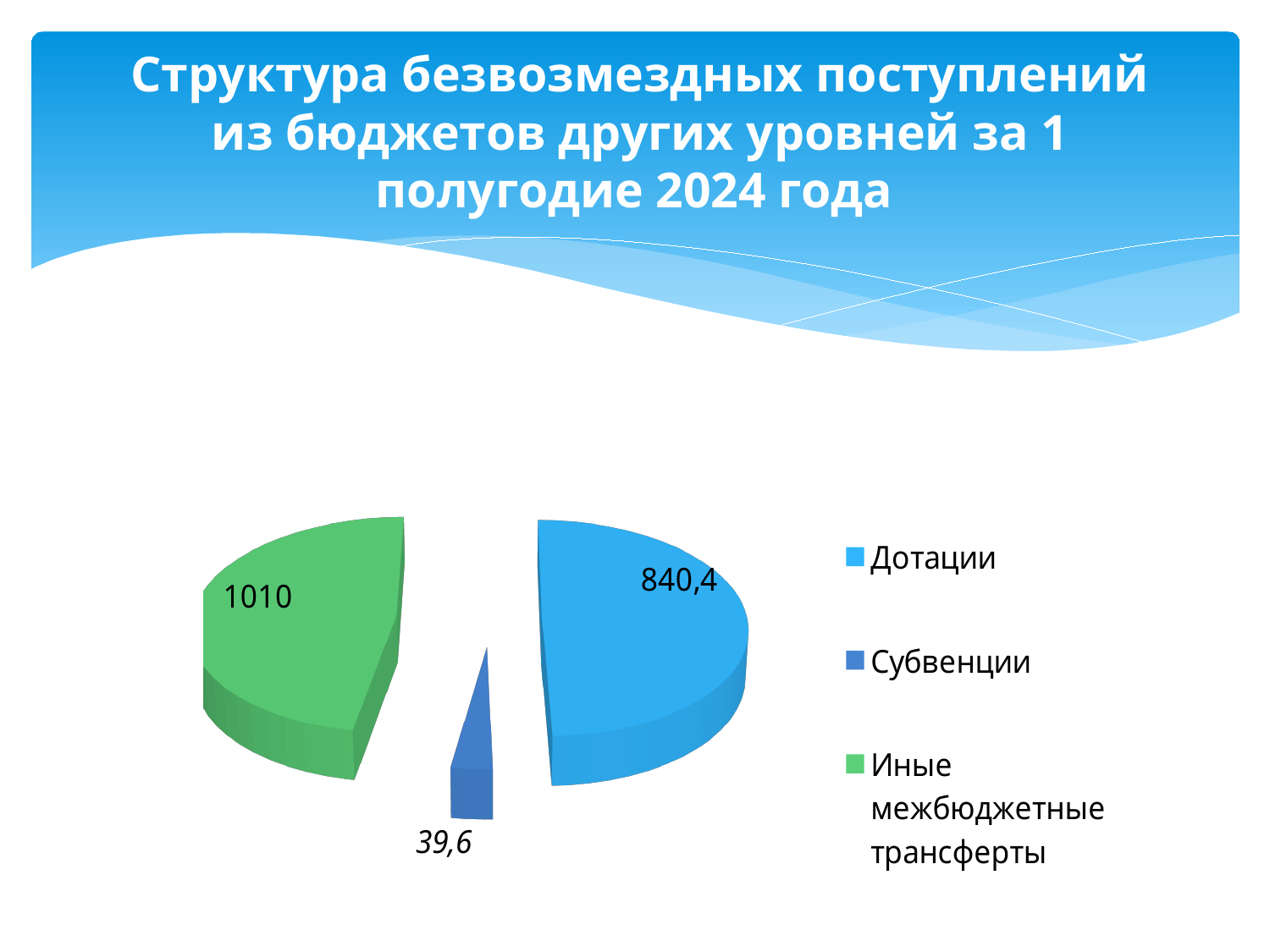
What is the value for Иные межбюджетные трансферты? 1010 What is the value for Субвенции? 39,6 What type of chart is shown on the slide? Pie chart Which is larger, Дотации or Субвенции? Дотации What is the difference between the values for Иные межбюджетные трансферты and Дотации? 169,6 Which category has the smallest value? Субвенции How many slices does the pie chart have? 3 What colour is the slice for Иные межбюджетные трансферты? Green What is the value for Дотации? 840,4 How many entries does the legend list? 3 What is the difference between the values for Дотации and Субвенции? 800,8